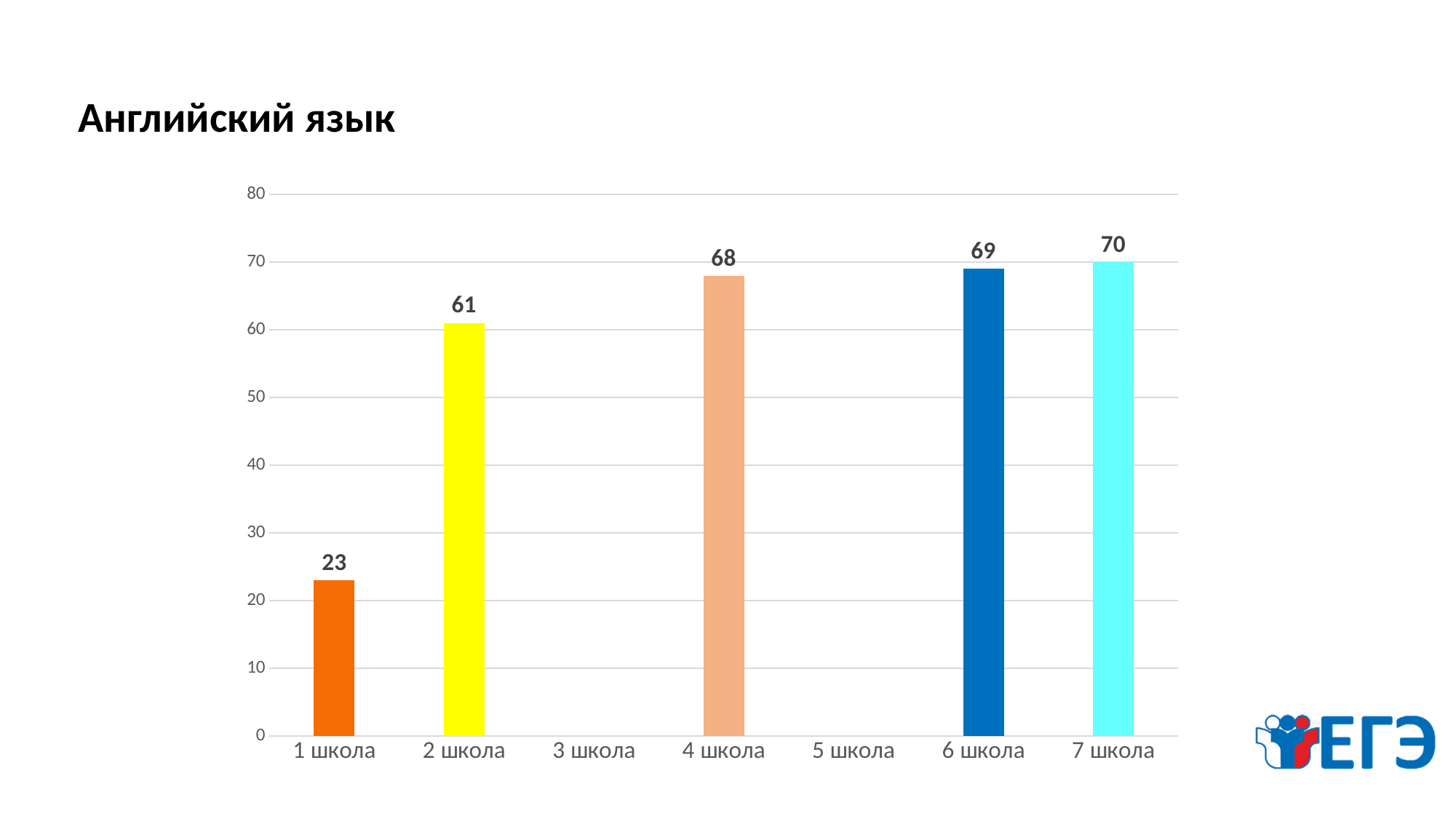
What is the value for 1 школа? 23 Which is larger, the value for 2 школа or the value for 6 школа? 6 школа What kind of chart is shown on the slide? bar chart Which school has the lowest value among the bars shown? 1 школа What is the difference between the values for 7 школа and 4 школа? 2 How many school categories are shown on the x axis? 7 What is the value for 4 школа? 68 Is the value for 4 школа greater or less than 60? greater What is the difference between the values for 2 школа and 1 школа? 38 What is the value for 7 школа? 70 What is the title of the slide? Английский язык Which school has the highest value among the bars shown? 7 школа